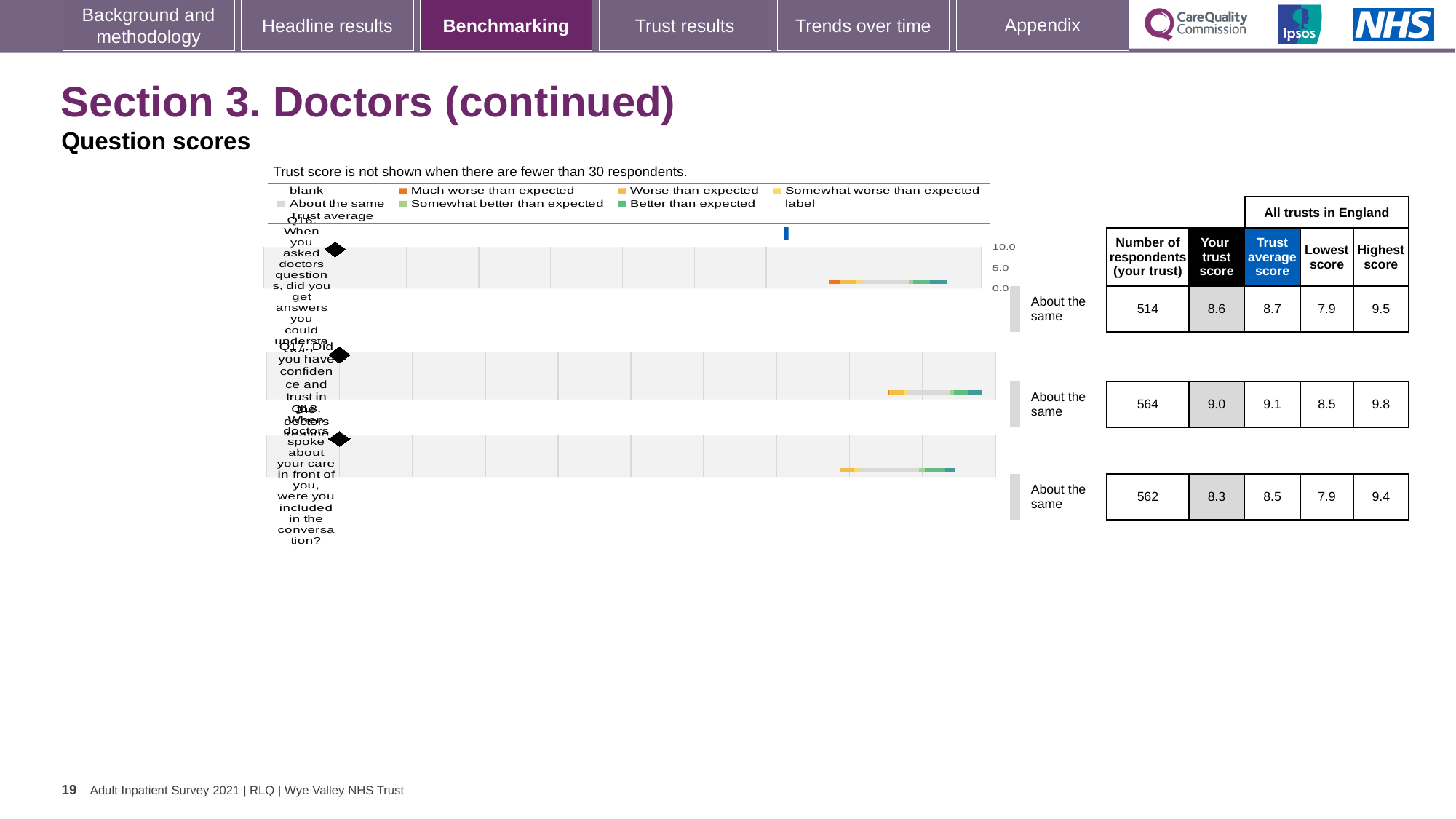
What is the highest score among all trusts in England for Q16? 9.5 What is the trust score for Q16 (When you asked doctors questions, did you get answers you could understand)? 8.6 What benchmark category is shown for all three questions on this slide? About the same What is the trust score for Q17 (Did you have confidence and trust in the doctors treating you)? 9.0 Which has the larger trust score, Q16 or Q18? Q16 What is the trust score for Q18 (When doctors spoke about your care in front of you, were you included in the conversation)? 8.3 How many respondents answered Q17 at this trust? 564 What is the difference between the trust score for Q17 and the trust score for Q16? 0.4 How many questions are plotted on the chart? 3 Which question has the highest trust score for this trust? Q17 What is the trust average score across all trusts in England for Q18? 8.5 Which question has the lowest trust score for this trust? Q18